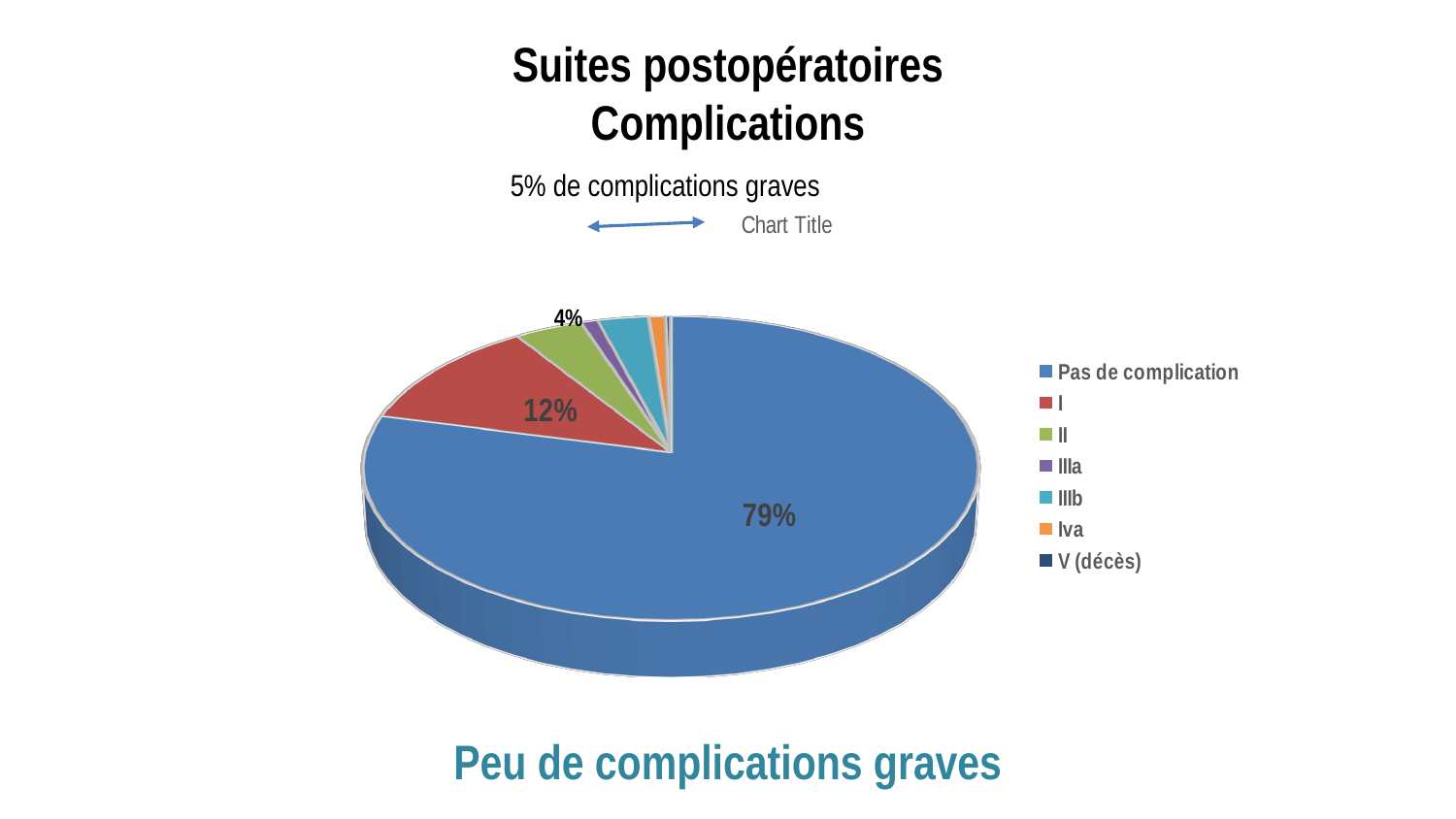
How many categories are listed in the chart legend? 7 Which is larger, the slice for "Pas de complication" or the slice for I? Pas de complication What is the difference in percentage points between the I slice and the II slice? 8 percentage points Which is larger, the slice for I or the slice for II? I What type of chart is shown on the slide? Pie chart Which category has the largest slice of the pie? Pas de complication What percentage is shown for category I? 12% What share of the pie does the "Pas de complication" slice represent? 79% What is the difference in percentage points between the "Pas de complication" slice and the I slice? 67 percentage points What colour represents "Pas de complication" in the legend? Blue What percentage is shown for category II? 4% What is the title displayed above the chart? Chart Title